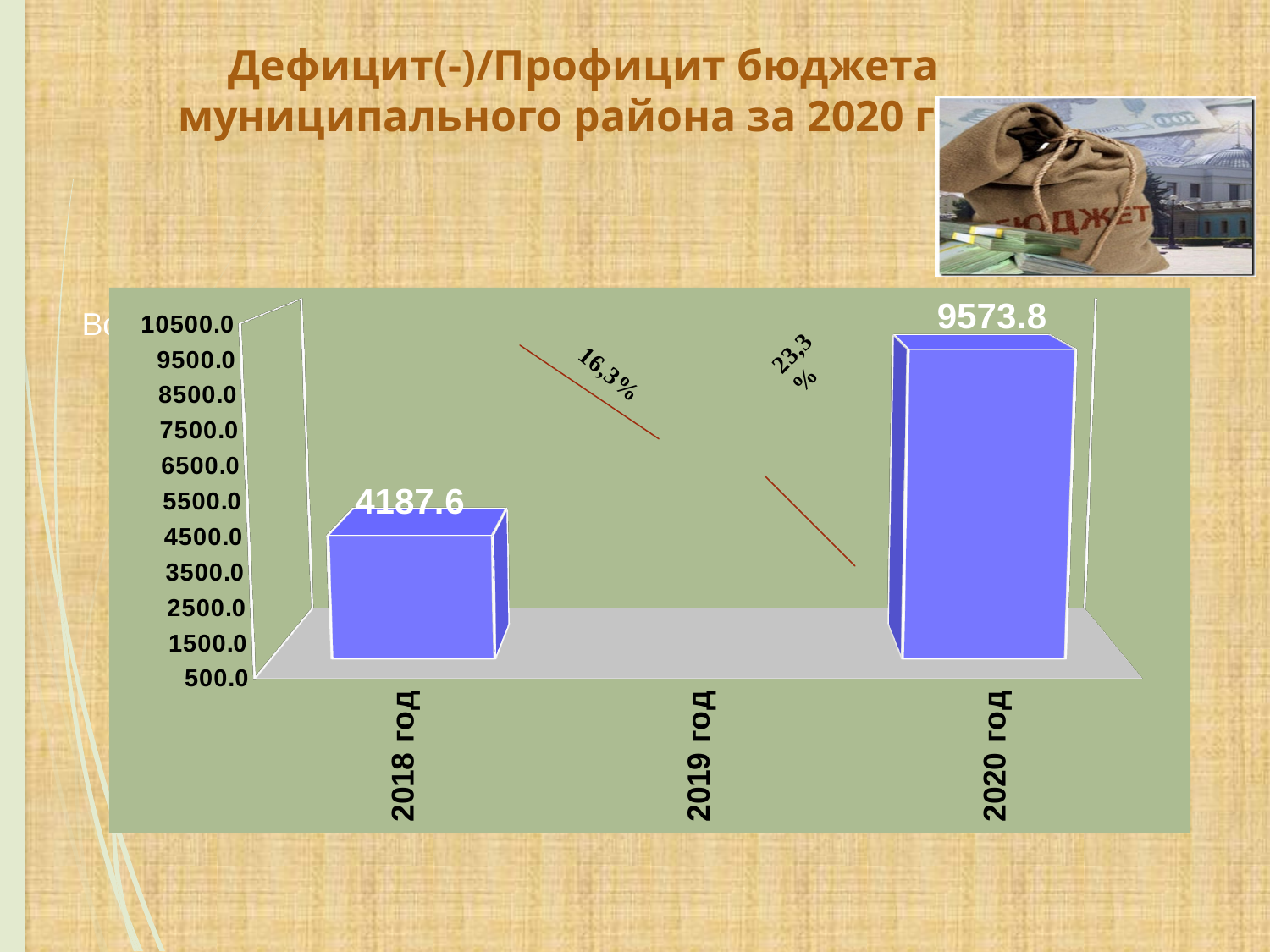
What is the difference between the values for 2020 год and 2018 год? 5386.2 What is the highest tick value shown on the vertical axis? 10500.0 Is the value for 2020 год greater or less than 8500? greater Which year has the highest bar on the chart? 2020 год Is the value for 2018 год greater or less than 5500? less Do the bar values rise or fall from 2018 год to 2020 год? rise How many year categories are labelled on the x axis? 3 Which is larger, the value for 2018 год or the value for 2020 год? 2020 год What is the value shown for 2020 год? 9573.8 What kind of chart is shown on the slide? bar chart What percentage is written next to the red line between 2018 год and 2019 год? 16,3% What is the value shown for 2018 год? 4187.6